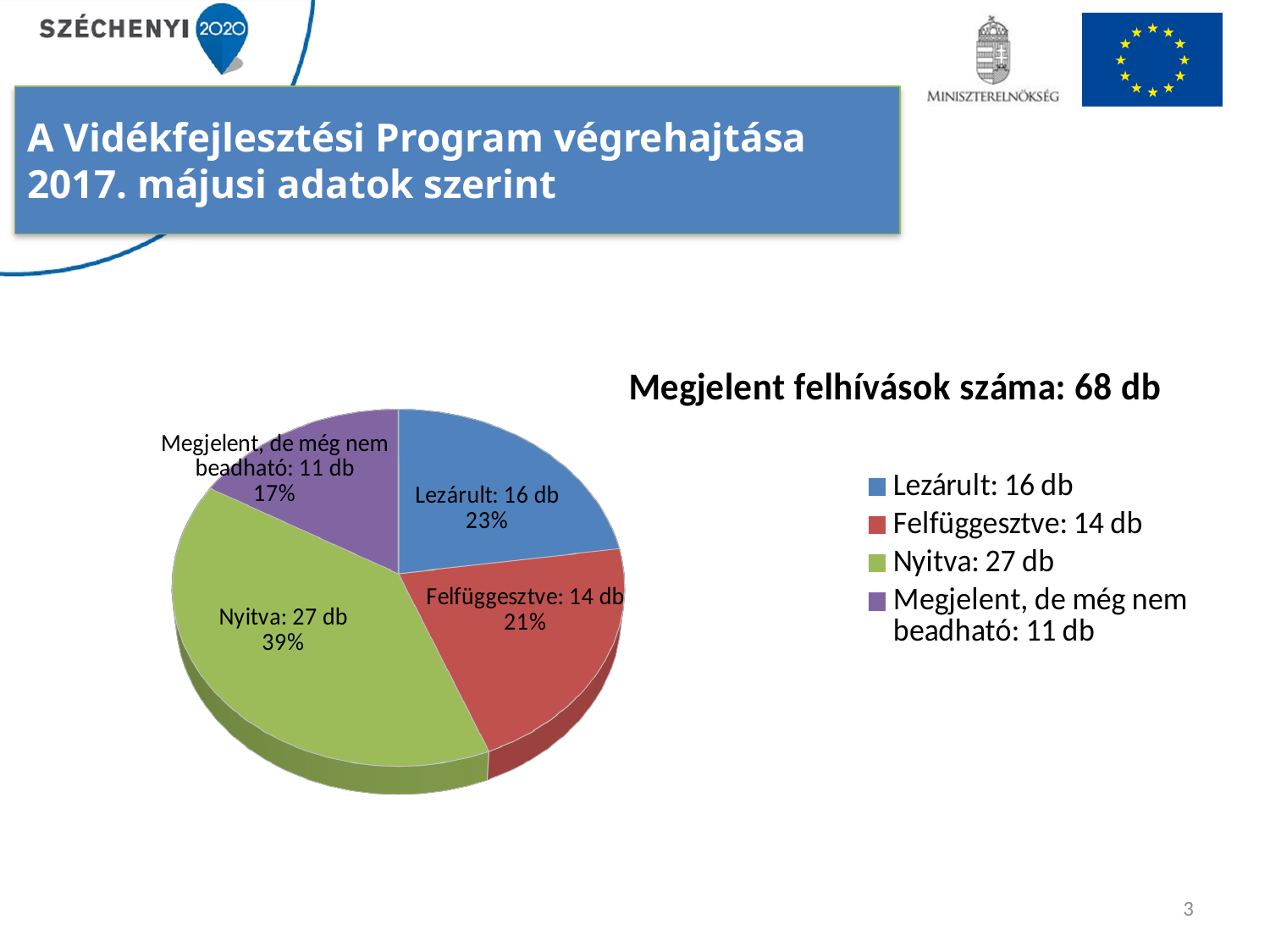
How many slices does the pie chart have? 4 Which category has the largest slice in the pie chart? Nyitva Which is larger, Lezárult or Felfüggesztve? Lezárult How many entries does the legend of the pie chart list? 4 What percentage share does the Lezárult slice have in the pie chart? 23% What percentage share does the Nyitva slice have in the pie chart? 39% What kind of chart is shown on the slide? pie chart What percentage share does the Felfüggesztve slice have in the pie chart? 21% Which category has the smallest slice in the pie chart? Megjelent, de még nem beadható What total number of published calls (Megjelent felhívások száma) is stated next to the pie chart? 68 db What is the difference in db between Nyitva and Lezárult? 11 db How many items (db) does the 'Megjelent, de még nem beadható' slice represent? 11 db